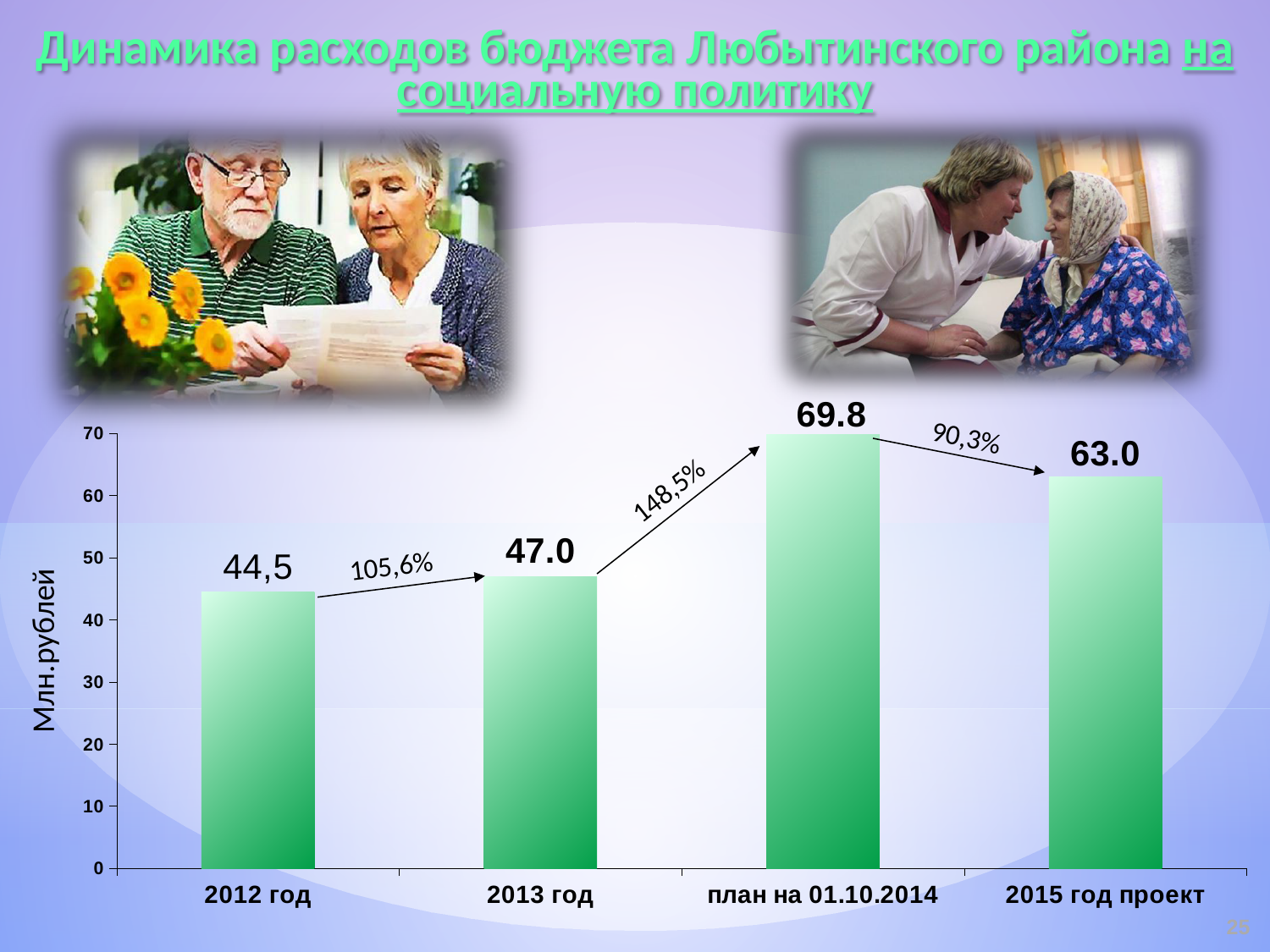
Which is larger, the value for 2013 год or the value for 2015 год проект? 2015 год проект Which category has the highest value? план на 01.10.2014 What is the value for 2015 год проект? 63.0 What is the value for 2012 год? 44,5 What is the difference between the values for план на 01.10.2014 and 2015 год проект? 6.8 What is the difference between the values for план на 01.10.2014 and 2013 год? 22.8 What is the value for план на 01.10.2014? 69.8 What kind of chart is this? bar chart Which category has the lowest value? 2012 год What is the label on the vertical axis? Млн.рублей What is the value for 2013 год? 47.0 How many categories are shown on the x axis? 4